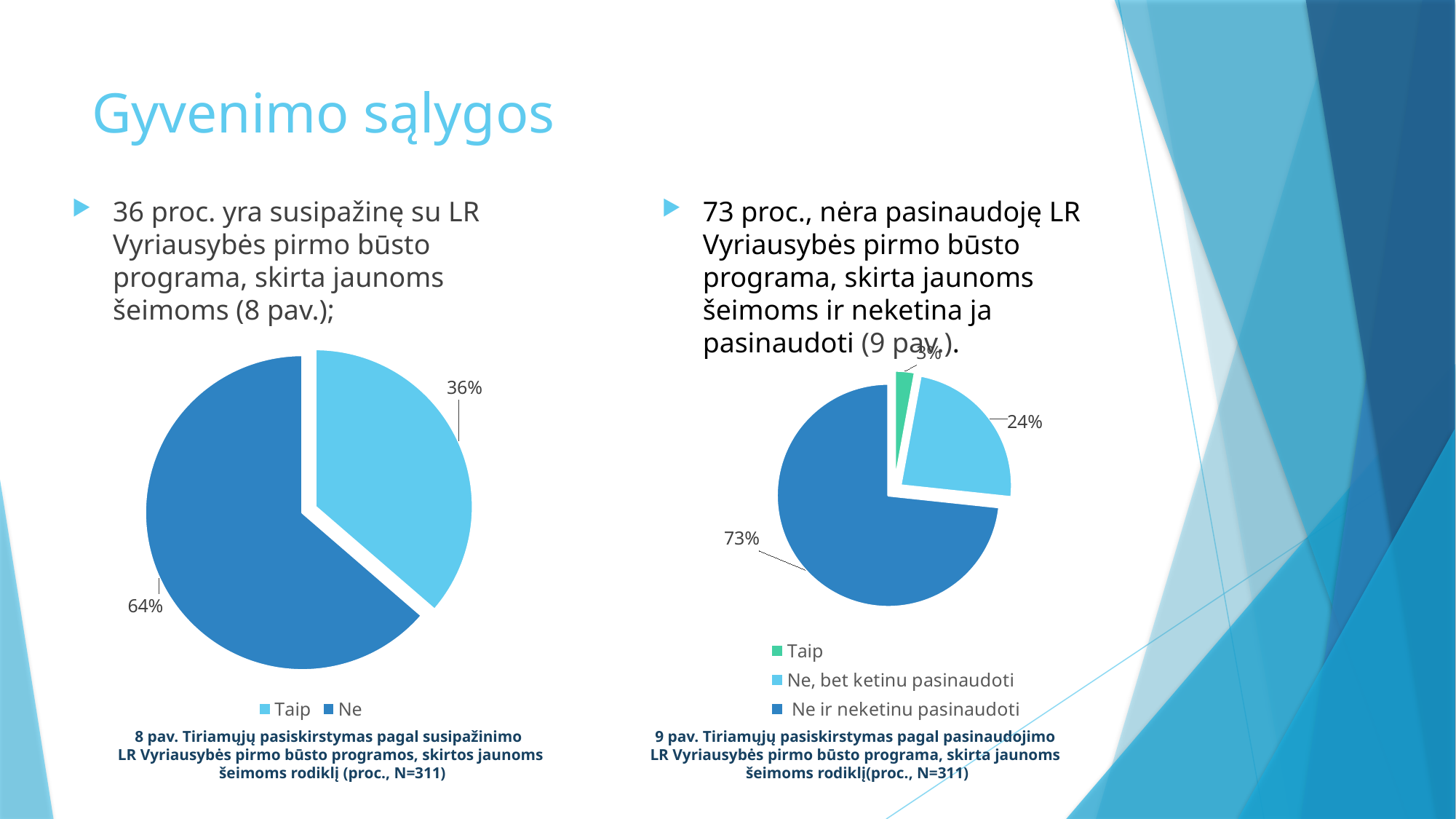
In the right pie chart (9 pav.), what share of respondents answered "Ne, bet ketinu pasinaudoti"? 24% In the right pie chart (9 pav.), what colour is the "Taip" slice? Green In the left pie chart (8 pav.), what is the difference in percentage points between "Ne" and "Taip"? 28 In the right pie chart (9 pav.), which category has the smallest slice? Taip In the left pie chart (8 pav.), what share of respondents answered "Taip"? 36% In the right pie chart (9 pav.), what share of respondents answered "Taip"? 3% In the left pie chart (8 pav.), which category has the largest slice? Ne How many categories does the legend of the right pie chart (9 pav.) list? 3 In the right pie chart (9 pav.), which is larger: "Ne, bet ketinu pasinaudoti" or "Ne ir neketinu pasinaudoti"? Ne ir neketinu pasinaudoti In the left pie chart (8 pav.), what share of respondents answered "Ne"? 64% In the right pie chart (9 pav.), what share of respondents answered "Ne ir neketinu pasinaudoti"? 73% What type of chart is shown on the left side of the slide? Pie chart